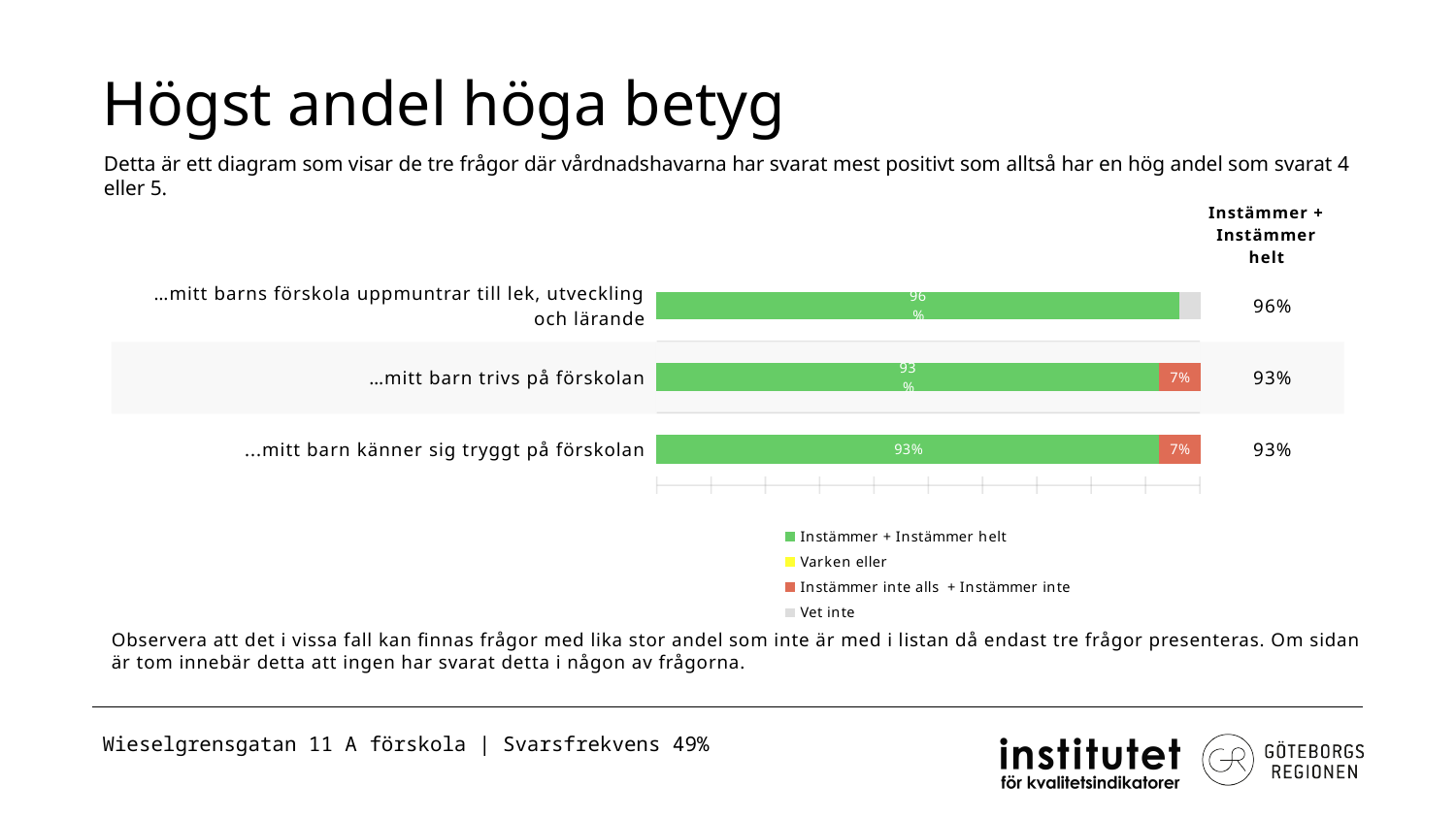
What is the title of the slide containing the chart? Högst andel höga betyg What is the 'Instämmer + Instämmer helt' value for '…mitt barn trivs på förskolan'? 93% Which question has the highest share of 'Instämmer + Instämmer helt'? …mitt barns förskola uppmuntrar till lek, utveckling och lärande How many series does the legend list? 4 Which is larger: the 'Instämmer + Instämmer helt' share for '…mitt barn trivs på förskolan' or the 'Instämmer inte alls + Instämmer inte' share for the same question? Instämmer + Instämmer helt What colour represents 'Instämmer + Instämmer helt' in the legend? Green How many questions (categories) are shown in the chart? 3 What is the total of the green and red segments for '…mitt barn trivs på förskolan'? 100% What is the 'Instämmer inte alls + Instämmer inte' value for '…mitt barn känner sig tryggt på förskolan'? 7% What is the 'Instämmer + Instämmer helt' value for '…mitt barns förskola uppmuntrar till lek, utveckling och lärande'? 96% What is the difference between the 'Instämmer + Instämmer helt' share for '…mitt barns förskola uppmuntrar till lek, utveckling och lärande' and for '…mitt barn trivs på förskolan'? 3 percentage points What kind of chart is shown on the slide? Stacked bar chart